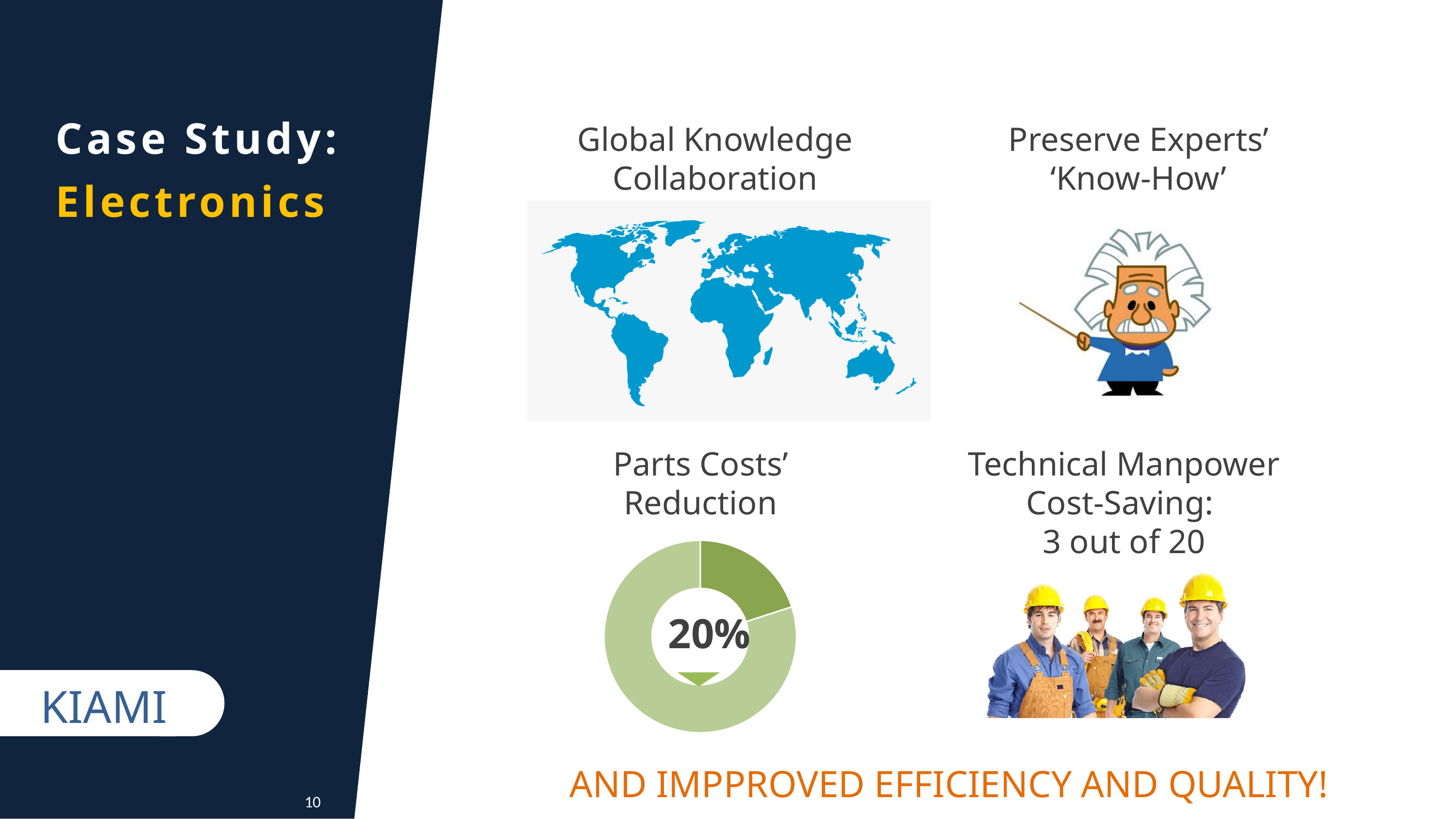
How many slices does the Parts Costs' Reduction doughnut chart have? 2 What colour is the 20% slice of the Parts Costs' Reduction doughnut chart? Dark green What metric does the doughnut chart on the slide illustrate? Parts Costs' Reduction What share of the Parts Costs' Reduction doughnut does the dark green slice represent? 20% In the Parts Costs' Reduction doughnut chart, which slice is larger, the dark green one or the light green one? The light green one What kind of chart is shown under the heading "Parts Costs' Reduction"? Doughnut chart What percentage is printed in the centre of the Parts Costs' Reduction doughnut chart? 20% Which slice of the Parts Costs' Reduction doughnut chart is the smallest? The dark green slice